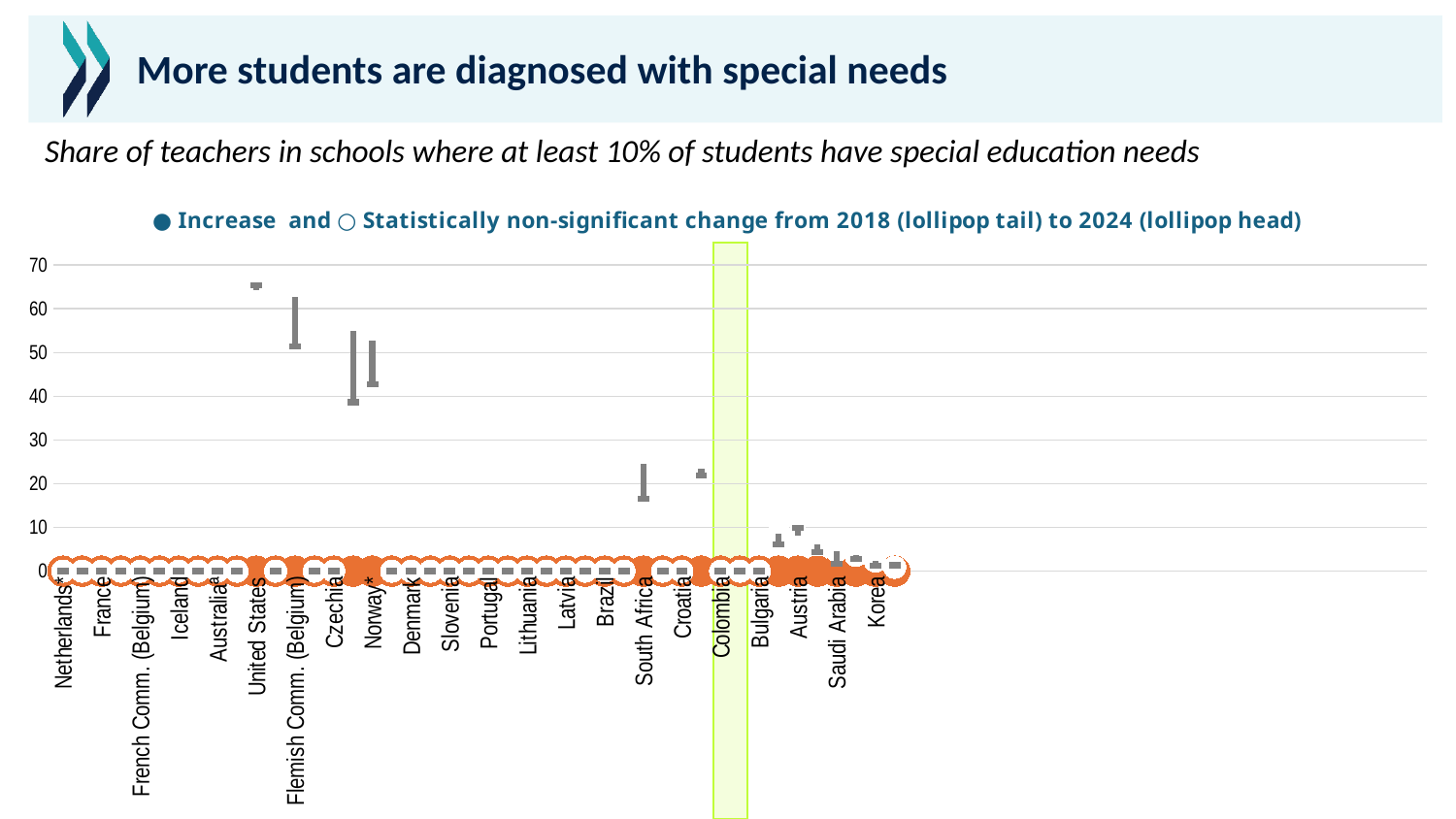
Is the 2018 (lollipop tail) value for United States greater or less than 60? greater How many entries does the chart legend list? 2 What kind of chart is shown on the slide? Lollipop chart Is the 2018 (lollipop tail) value for Croatia greater or less than 30? less Is the 2018 (lollipop tail) value for Austria greater or less than 20? less Which year does the lollipop tail represent according to the legend? 2018 What does the chart's subtitle say is being measured? Share of teachers in schools where at least 10% of students have special education needs Which year does the lollipop head represent according to the legend? 2024 What is the highest value shown on the chart's vertical axis? 70 Which country is highlighted with a shaded box on the chart? Colombia What is the title of the slide containing the chart? More students are diagnosed with special needs